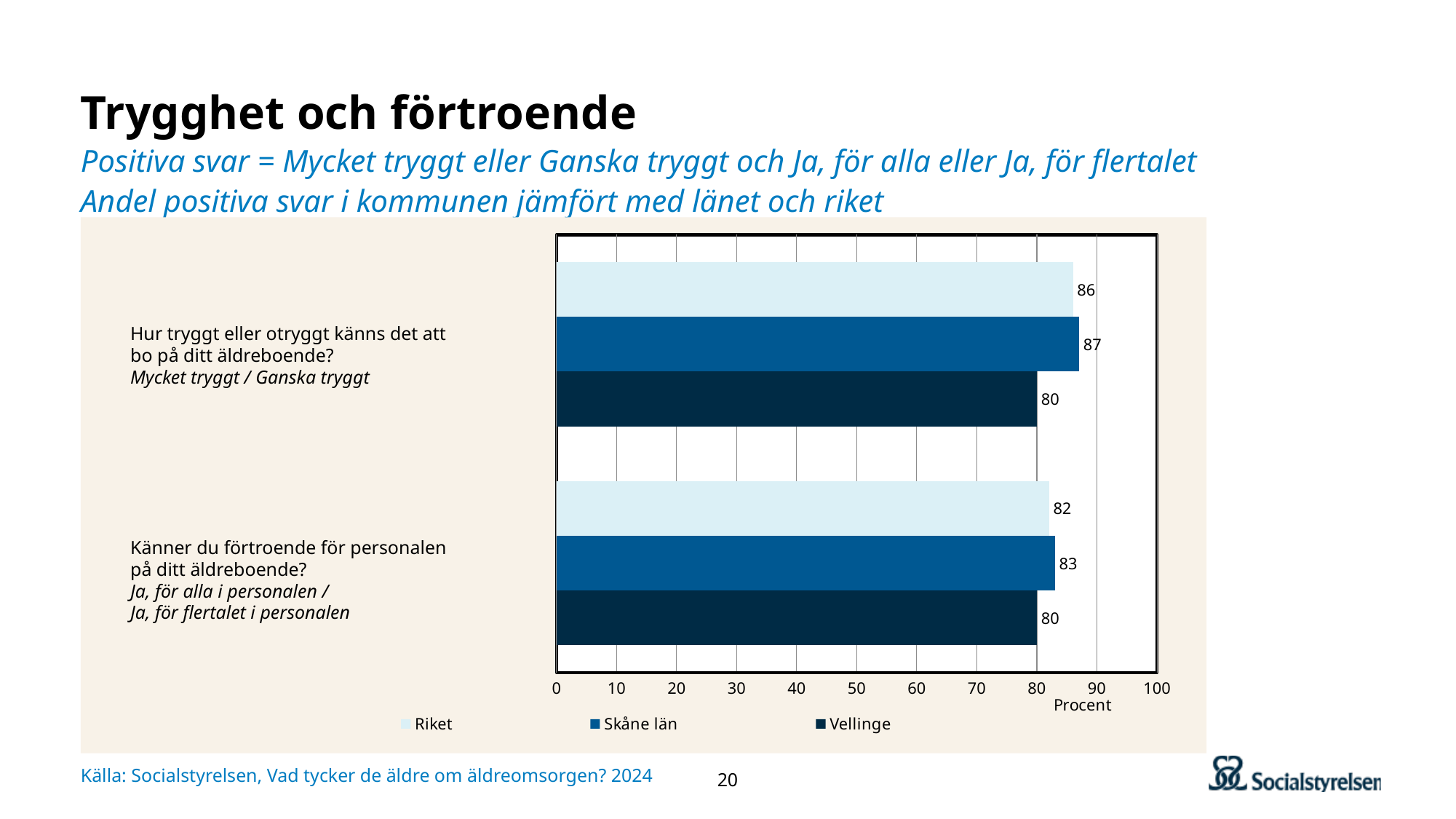
Which is larger: Riket on the trygghet question or Riket on the förtroende question? Riket on the trygghet question What kind of chart is shown on the slide? Bar chart How many series does the legend list? 3 What is the value for Riket on the question 'Hur tryggt eller otryggt känns det att bo på ditt äldreboende?' 86 What unit is shown on the x axis of the chart? Procent What is the difference between Skåne län and Vellinge on the question 'Hur tryggt eller otryggt känns det att bo på ditt äldreboende?' 7 What is the difference between Riket and Vellinge on the question 'Känner du förtroende för personalen på ditt äldreboende?' 2 Which series has the highest value on the question 'Hur tryggt eller otryggt känns det att bo på ditt äldreboende?' Skåne län What is the value for Vellinge on the question 'Känner du förtroende för personalen på ditt äldreboende?' 80 Which series has the lowest value on the question 'Känner du förtroende för personalen på ditt äldreboende?' Vellinge What is the value for Skåne län on the question 'Hur tryggt eller otryggt känns det att bo på ditt äldreboende?' 87 What is the value for Riket on the question 'Känner du förtroende för personalen på ditt äldreboende?' 82